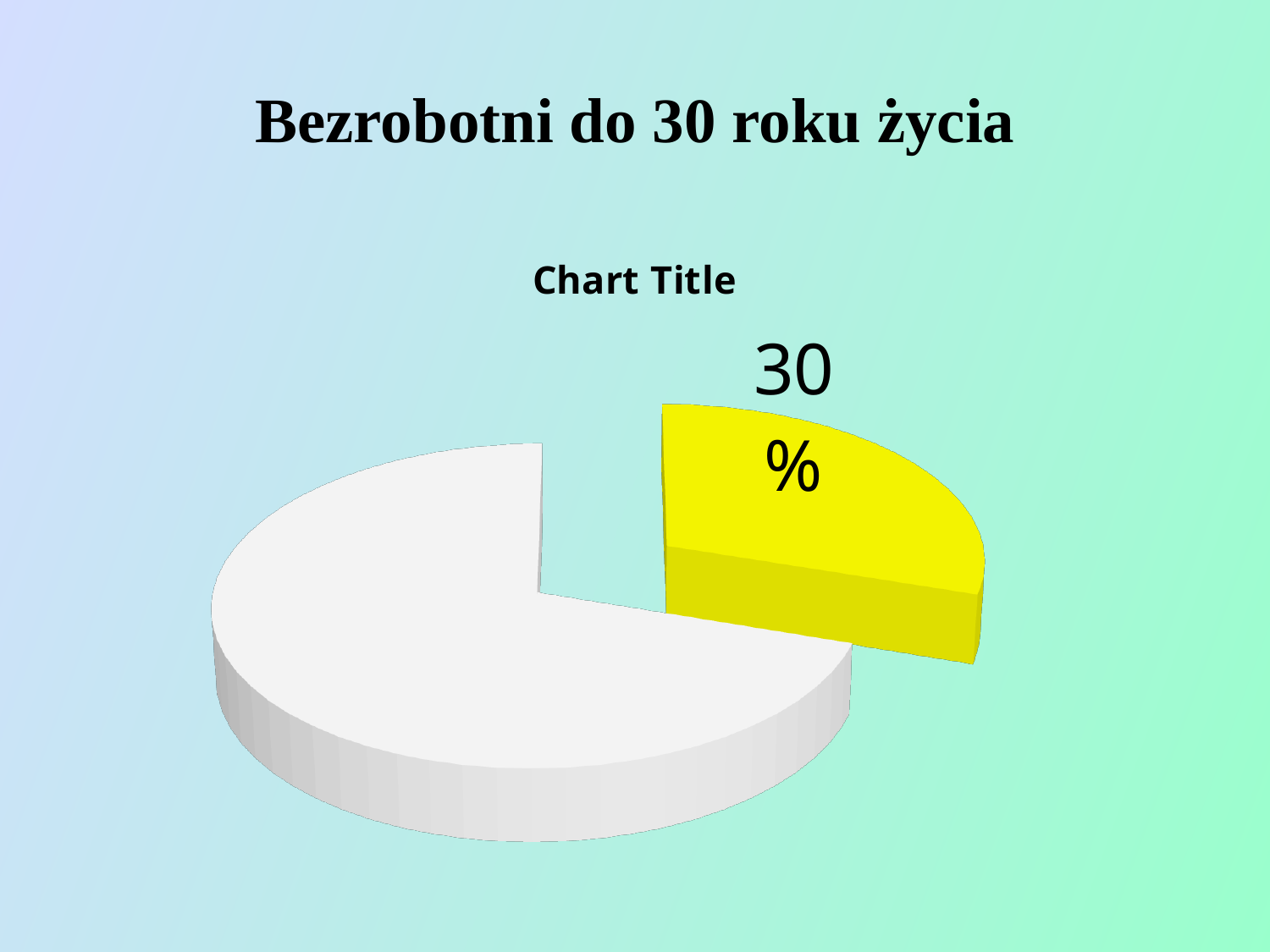
How many slices does the pie chart have? 2 What is the title printed above the pie chart? Chart Title Which slice of the pie chart is larger, the yellow slice or the white slice? the white slice What colour is the exploded (pulled-out) slice of the pie chart? yellow What value is printed on the yellow slice of the pie chart? 30% Is the value of the yellow slice greater or less than 50%? less Which slice of the pie chart is the smallest? the yellow slice What kind of chart is shown on the slide? pie chart